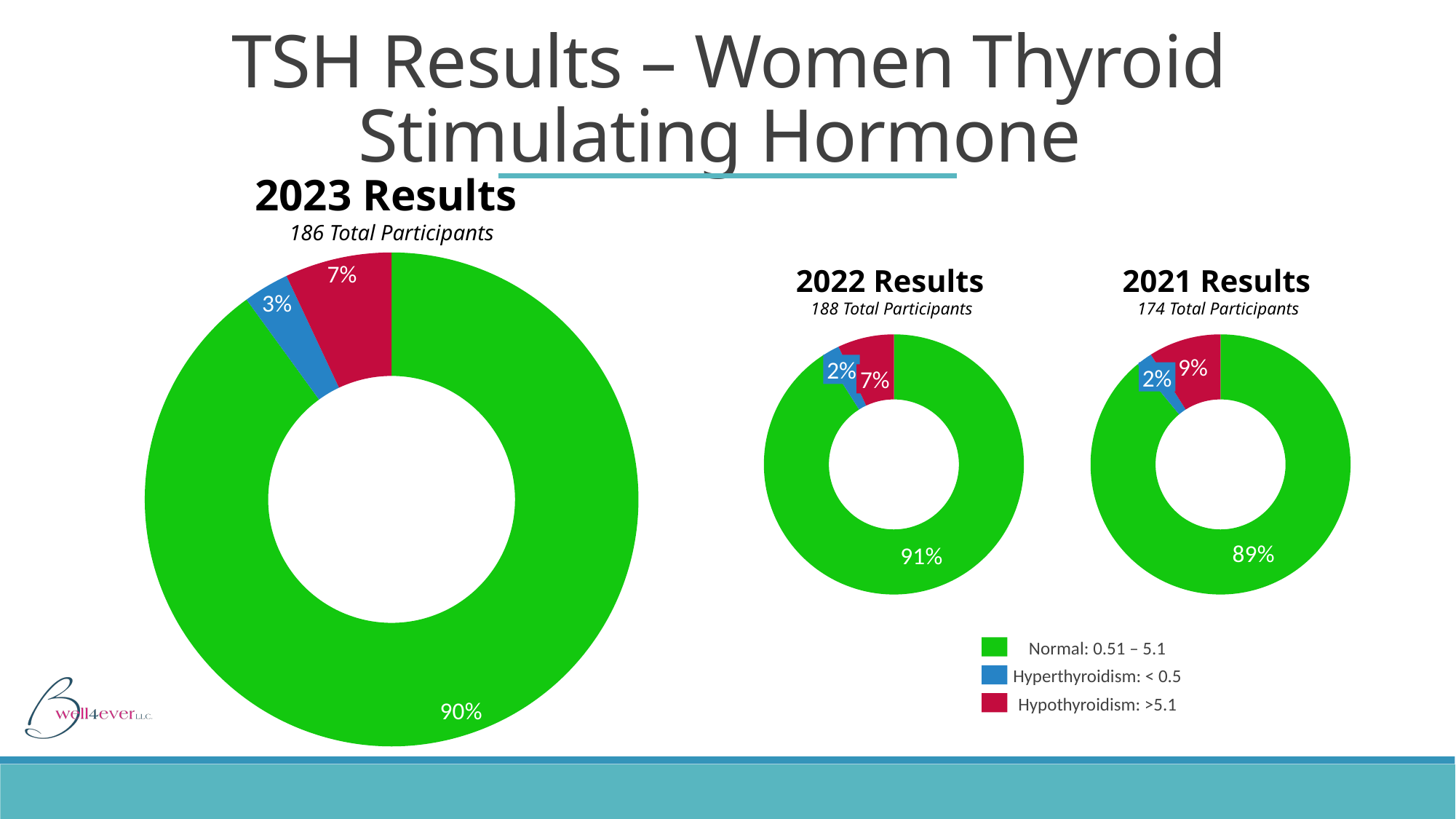
Is the Hypothyroidism share larger in the 2021 Results chart or the 2022 Results chart? 2021 Results How many categories does the legend list? 3 How many total participants are shown for the 2022 Results chart? 188 In the 2021 Results chart, which category has the smallest share? Hyperthyroidism In the 2021 Results chart, what is the difference in percentage points between the Hypothyroidism and Hyperthyroidism shares? 7 What kind of chart is used for the 2023 Results? Doughnut chart In the 2022 Results chart, what percentage of participants fell in the Hypothyroidism category? 7% In the 2021 Results chart, what percentage of participants had Normal TSH results? 89% In the 2023 Results chart, what percentage of participants had Normal TSH results? 90% Which colour represents Hyperthyroidism in the charts? Blue In the 2023 Results chart, what percentage of participants fell in the Hyperthyroidism category? 3% In the 2023 Results chart, which category has the largest share? Normal